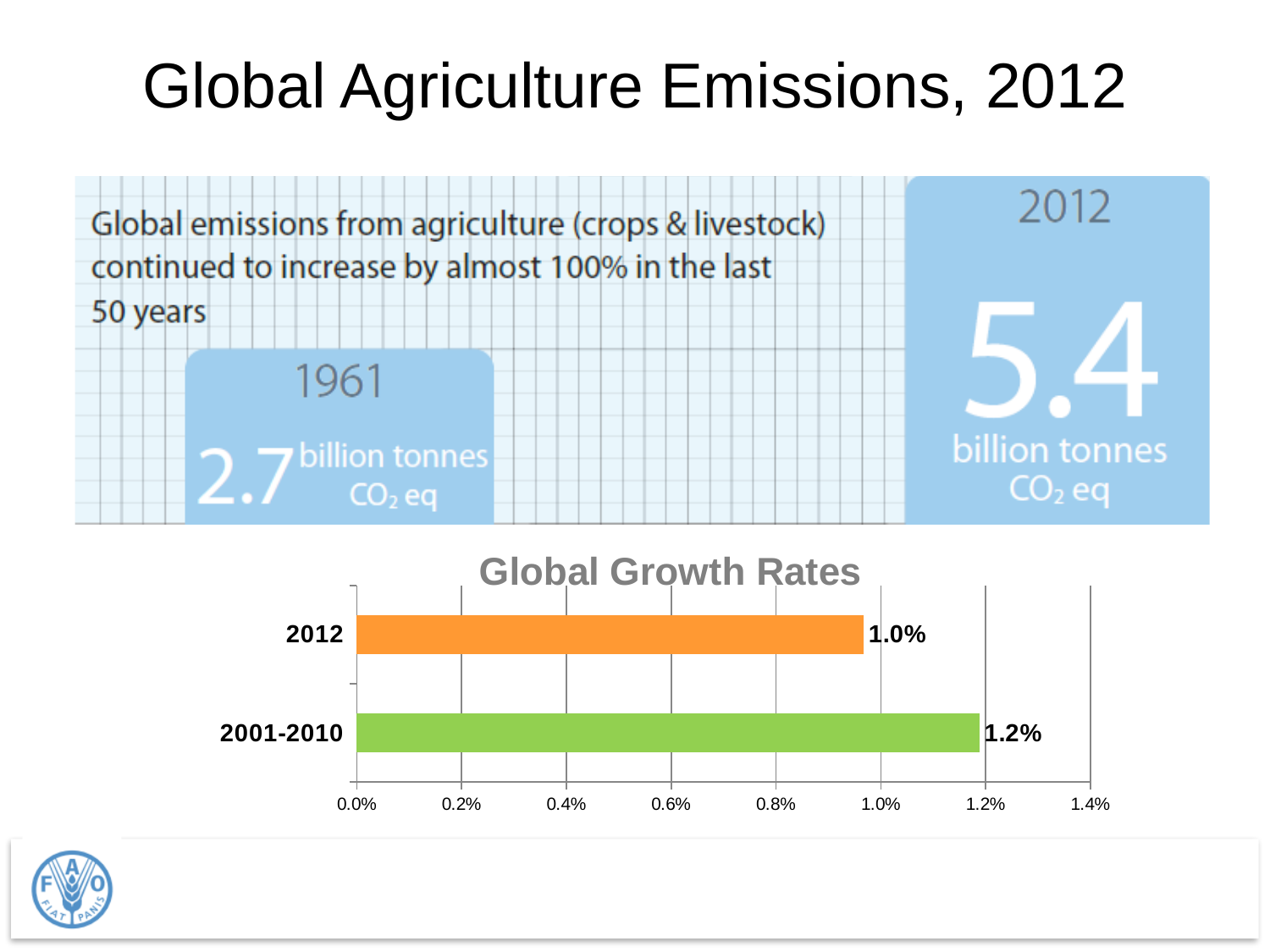
In the Global Growth Rates chart, what colour is the bar for 2012? orange In the Global Growth Rates chart, which is larger: the value for 2012 or the value for 2001-2010? 2001-2010 In the Global Growth Rates chart, what is the difference between the 2001-2010 value and the 2012 value? 0.2% What kind of chart is the Global Growth Rates chart? bar chart How many categories are shown in the Global Growth Rates chart? 2 In the Global Growth Rates chart, which category has the lowest value? 2012 What is the title of the bar chart on the slide? Global Growth Rates In the Global Growth Rates chart, is the value for 2012 greater or less than 0.8%? greater In the Global Growth Rates chart, is the value for 2001-2010 greater or less than 1.4%? less In the Global Growth Rates chart, what is the value for 2001-2010? 1.2% In the Global Growth Rates chart, which category has the highest value? 2001-2010 In the Global Growth Rates chart, what is the value for 2012? 1.0%